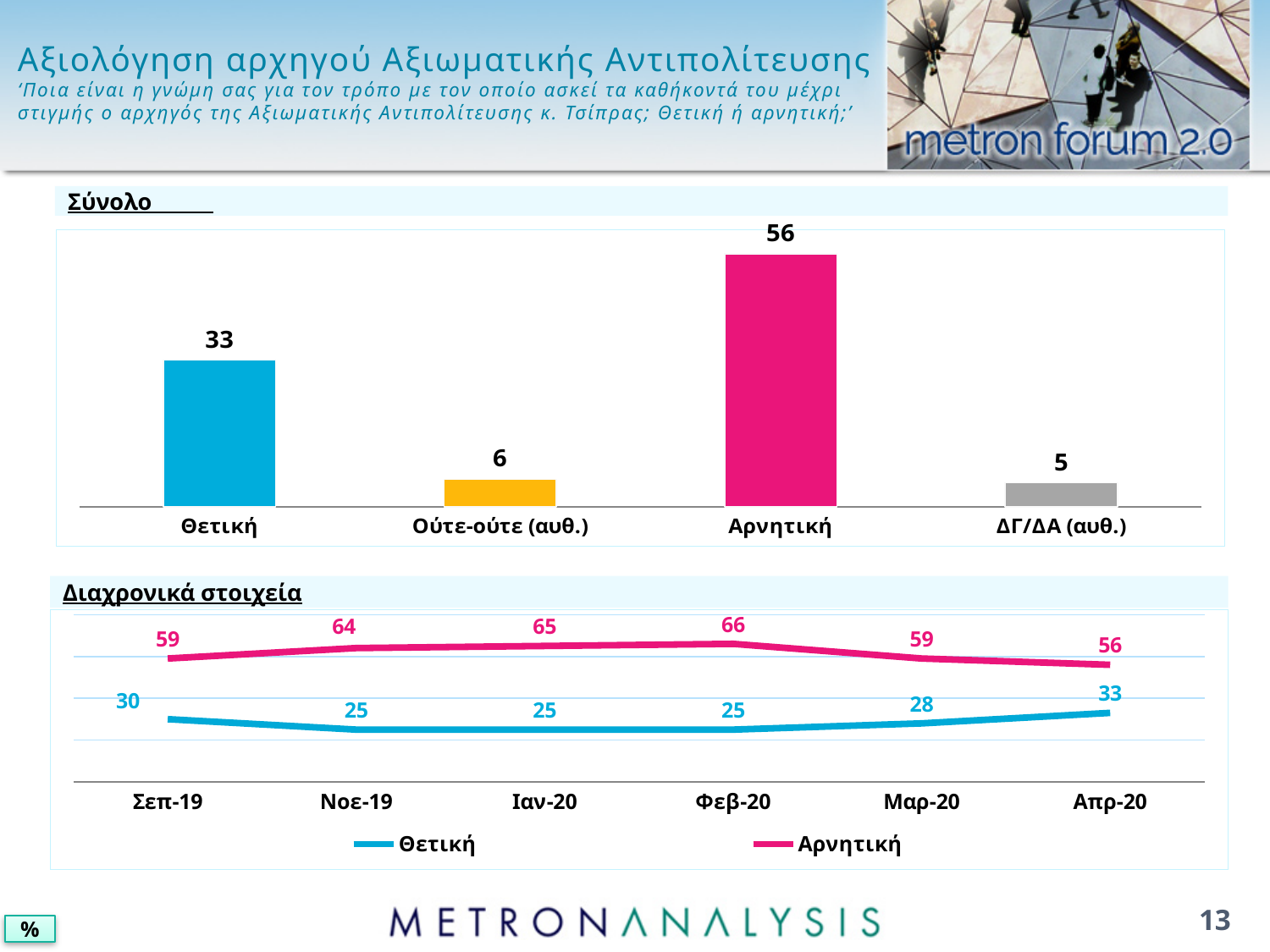
In the 'Διαχρονικά στοιχεία' line chart, what is the value for Αρνητική in Φεβ-20? 66 In the 'Διαχρονικά στοιχεία' line chart, what is the value for Θετική in Σεπ-19? 30 In the 'Σύνολο' bar chart, what is the value for Αρνητική? 56 In the 'Διαχρονικά στοιχεία' line chart, does the Αρνητική series rise or fall from Φεβ-20 to Απρ-20? fall In the 'Σύνολο' bar chart, what is the difference between Αρνητική and Θετική? 23 In the 'Διαχρονικά στοιχεία' line chart, which is larger in Μαρ-20: Θετική or Αρνητική? Αρνητική In the 'Σύνολο' bar chart, what is the value for Θετική? 33 In the 'Διαχρονικά στοιχεία' line chart, how many series does the legend list? 2 In the 'Σύνολο' bar chart, how many categories are shown? 4 In the 'Σύνολο' bar chart, which category has the lowest value? ΔΓ/ΔΑ (αυθ.) What kind of chart is the 'Σύνολο' chart? bar chart In the 'Διαχρονικά στοιχεία' line chart, how many time points are shown on the x axis? 6